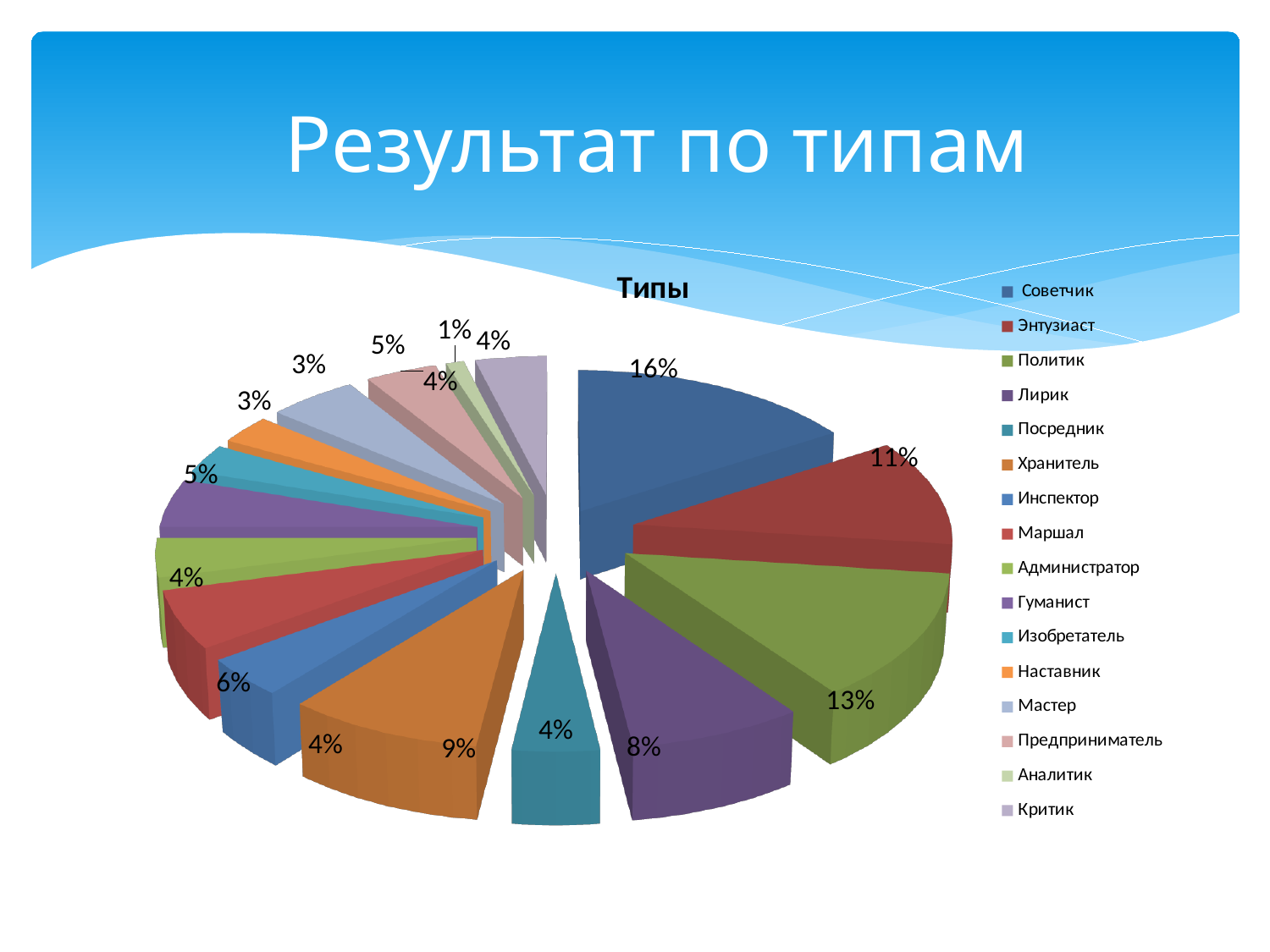
What share of the pie does Политик have? 13% What share of the pie does Советчик have? 16% What is the difference between the shares of Советчик and Политик? 3% How many categories does the legend list? 16 What share of the pie does Аналитик have? 1% What is the title of the chart? Типы Which is larger, the share of Лирик or the share of Маршал? Лирик What kind of chart is shown on the slide? pie chart Which category has the smallest share of the pie? Аналитик Which category has the largest share of the pie? Советчик